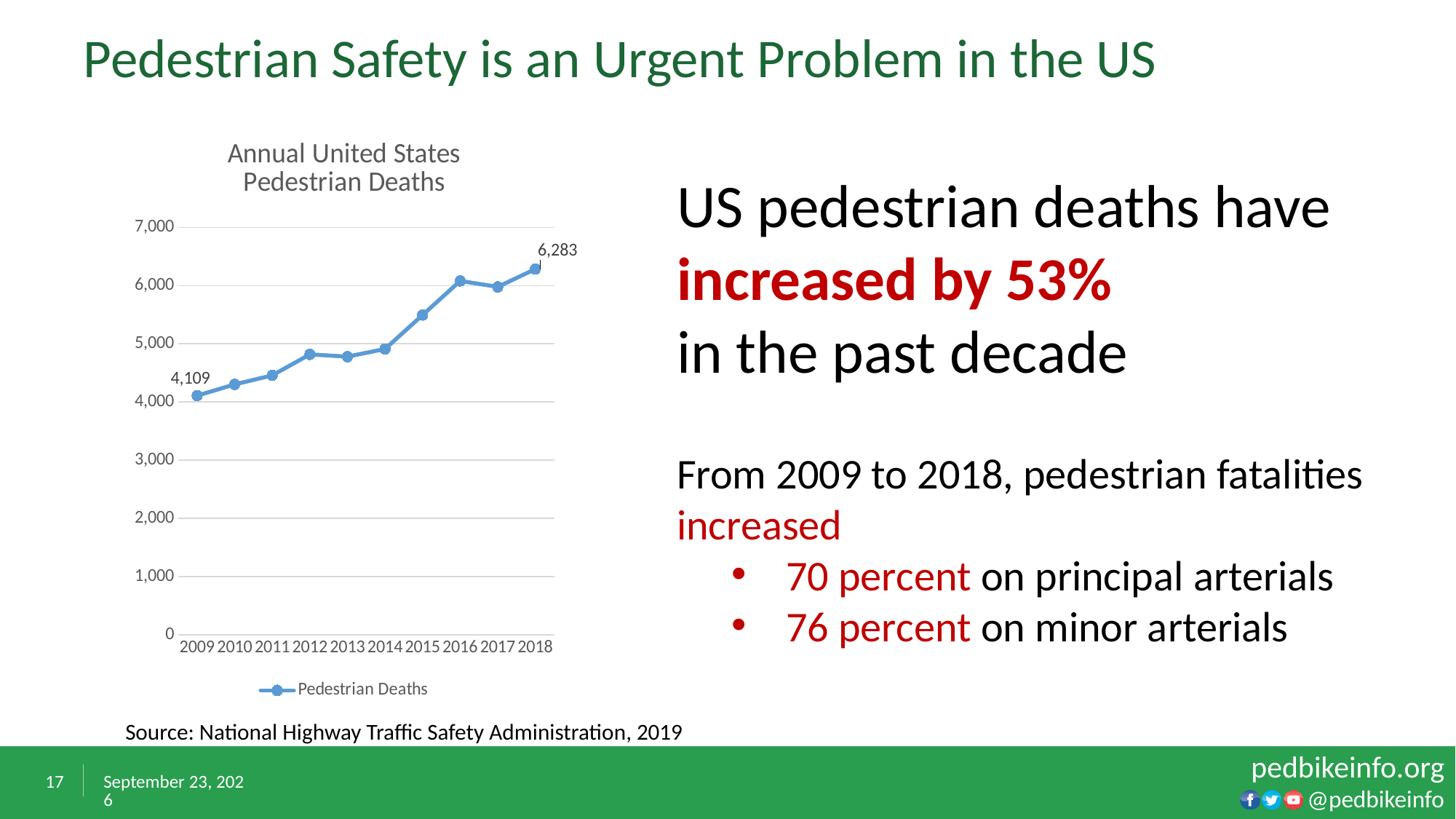
What is the difference between the pedestrian deaths in 2018 and in 2009? 2,174 Is the value for 2016 greater or less than 6,000? greater What kind of chart is shown on the slide? line chart Do pedestrian deaths generally rise or fall from 2009 to 2018 in the chart? rise Is the value for 2014 greater or less than 5,000? less What is the value for 2009 in the Annual United States Pedestrian Deaths chart? 4,109 Which year has more pedestrian deaths, 2015 or 2016? 2016 How many years are plotted on the x axis of the chart? 10 Which year has the highest number of pedestrian deaths in the chart? 2018 How many series does the chart's legend list? 1 What is the value for 2018 in the Annual United States Pedestrian Deaths chart? 6,283 Which year has the lowest number of pedestrian deaths in the chart? 2009